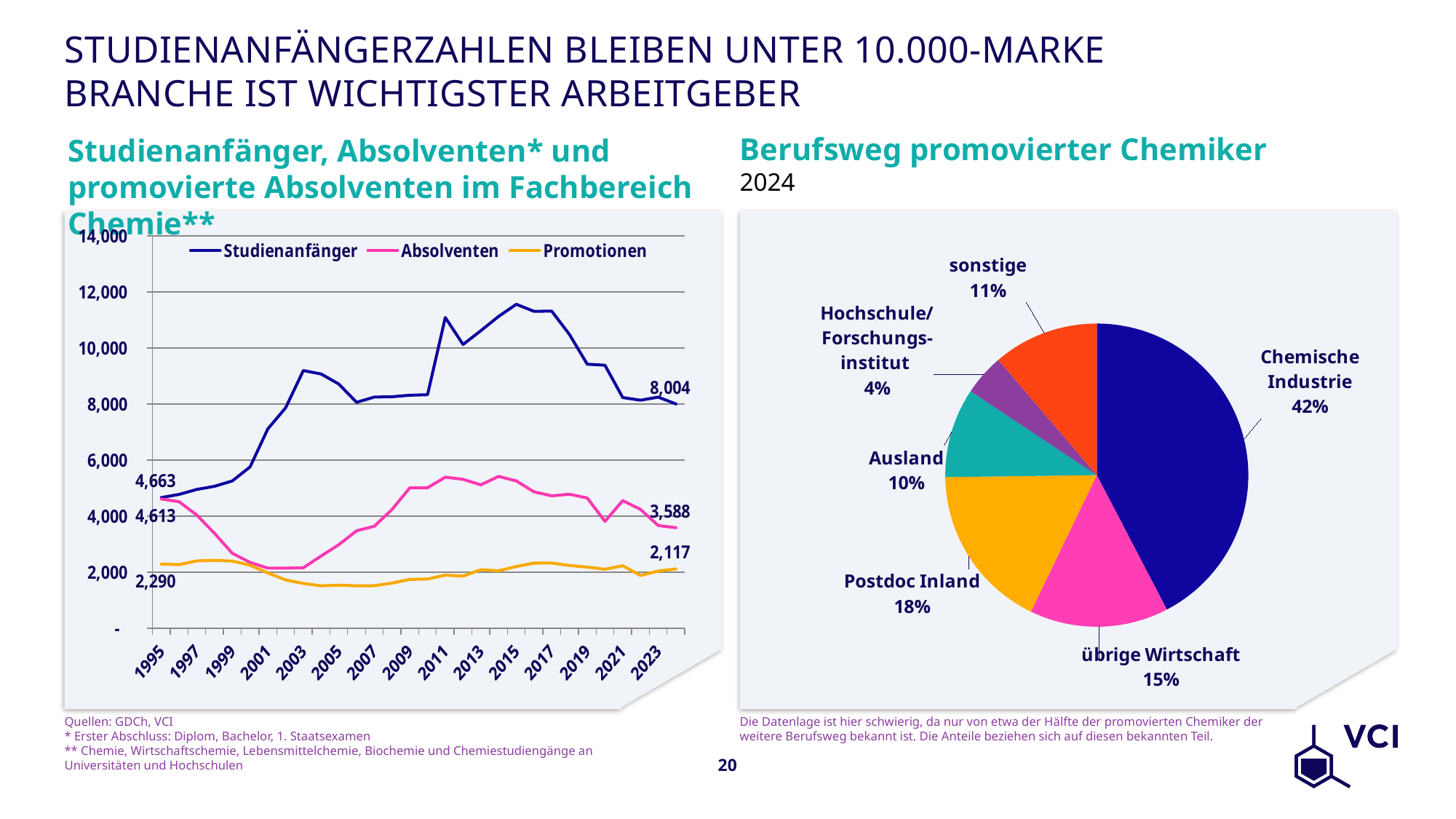
In the pie chart 'Berufsweg promovierter Chemiker', how many percentage points larger is Postdoc Inland than übrige Wirtschaft? 3 percentage points In the left line chart, what is the most recent value shown for Studienanfänger? 8,004 In the pie chart 'Berufsweg promovierter Chemiker', what share is shown for Chemische Industrie? 42% How many series does the legend of the left line chart list? 3 In the left line chart, what is the difference between Studienanfänger (4,663) and Absolventen (4,613) in 1995? 50 In the pie chart 'Berufsweg promovierter Chemiker', which category has the smallest slice? Hochschule/Forschungsinstitut In the left line chart, is the value for Studienanfänger in 2015 greater or less than 10,000? greater In the pie chart 'Berufsweg promovierter Chemiker', which is larger: Ausland or sonstige? sonstige In the pie chart 'Berufsweg promovierter Chemiker', which category has the largest slice? Chemische Industrie In the left line chart, what is the value for Studienanfänger in 1995? 4,663 How many slices does the pie chart 'Berufsweg promovierter Chemiker' have? 6 What kind of chart is the left chart about Studienanfänger, Absolventen and promovierte Absolventen? Line chart